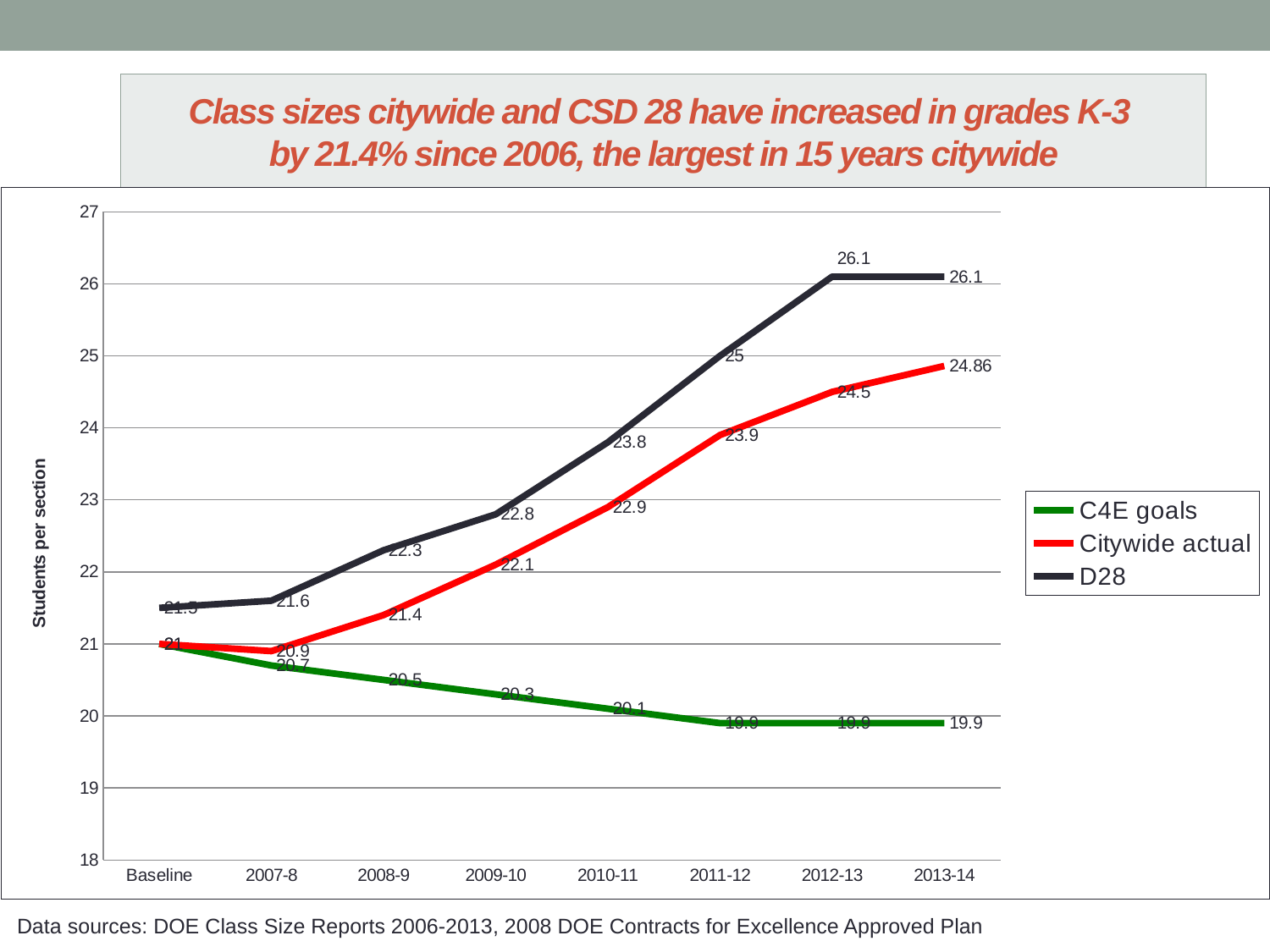
Is the Citywide actual value for 2012-13 greater or less than 24? greater How many categories are shown along the x axis? 8 What is the difference between the D28 and Citywide actual values in 2013-14? 1.24 How many series does the legend list? 3 What is the Citywide actual value for 2013-14? 24.86 What is the D28 value for 2013-14? 26.1 What kind of chart is shown on the slide? Line chart What is the C4E goals value for 2013-14? 19.9 What is the D28 value for 2011-12? 25 Do the C4E goals values rise or fall from Baseline to 2013-14? Fall In 2010-11, which is larger: the D28 value or the Citywide actual value? D28 What is the Citywide actual value for 2009-10? 22.1